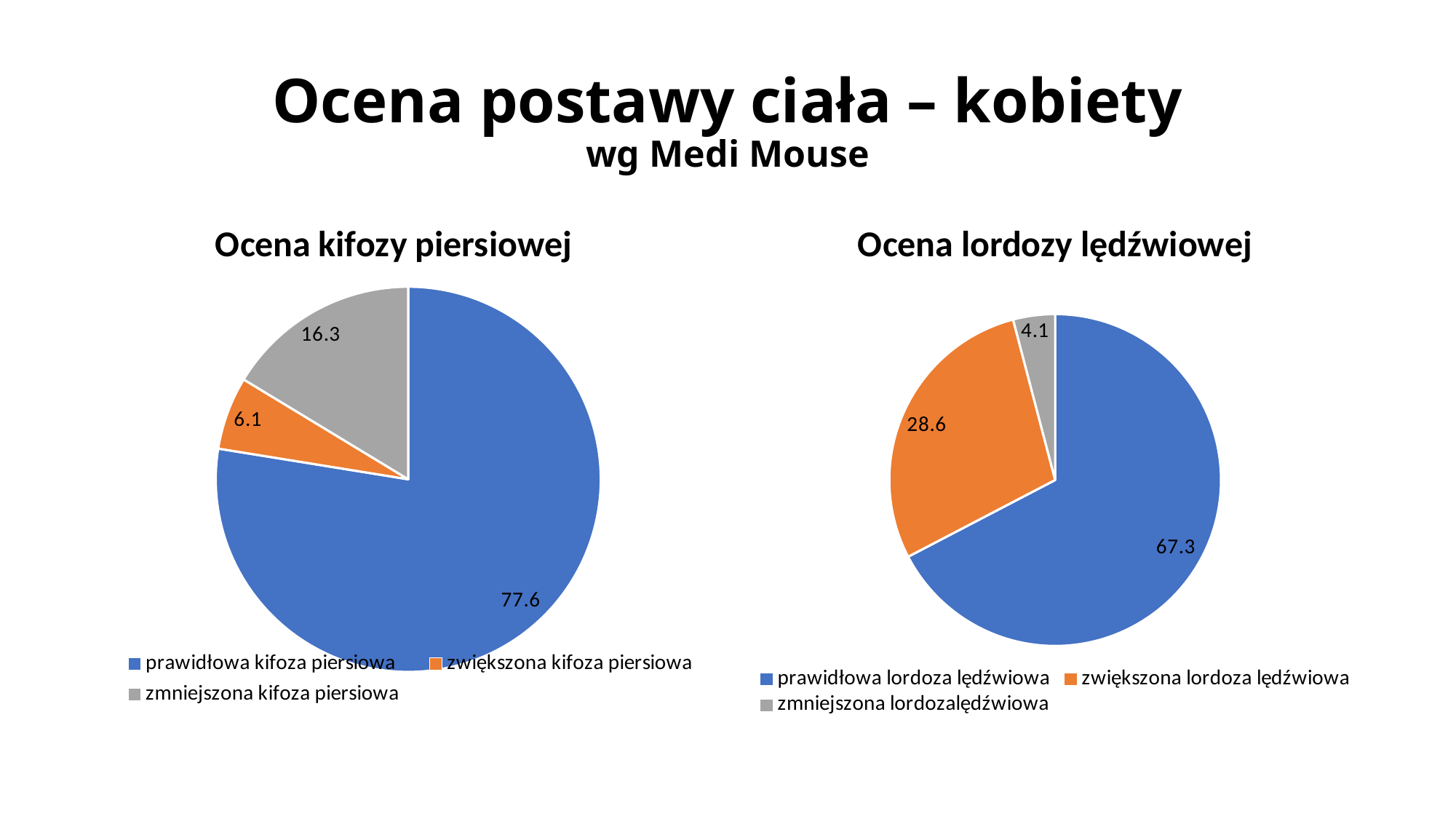
In the 'Ocena kifozy piersiowej' chart, which category has the smallest slice? zwiększona kifoza piersiowa Which is larger: zwiększona kifoza piersiowa in the left chart or zwiększona lordoza lędźwiowa in the right chart? zwiększona lordoza lędźwiowa In the 'Ocena lordozy lędźwiowej' chart, which category has the largest slice? prawidłowa lordoza lędźwiowa In the 'Ocena lordozy lędźwiowej' chart, what is the value for zmniejszona lordoza lędźwiowa? 4.1 In the 'Ocena lordozy lędźwiowej' chart, what is the value for zwiększona lordoza lędźwiowa? 28.6 How many slices does the 'Ocena lordozy lędźwiowej' chart have? 3 In the 'Ocena lordozy lędźwiowej' chart, what is the difference between the values for prawidłowa lordoza lędźwiowa and zwiększona lordoza lędźwiowa? 38.7 In the 'Ocena kifozy piersiowej' chart, what is the difference between the values for zmniejszona kifoza piersiowa and zwiększona kifoza piersiowa? 10.2 In the 'Ocena kifozy piersiowej' chart, what is the value for zmniejszona kifoza piersiowa? 16.3 In the 'Ocena kifozy piersiowej' chart, what colour is the slice for zmniejszona kifoza piersiowa? grey In the 'Ocena kifozy piersiowej' chart, what is the value for prawidłowa kifoza piersiowa? 77.6 What type of chart is 'Ocena kifozy piersiowej'? pie chart